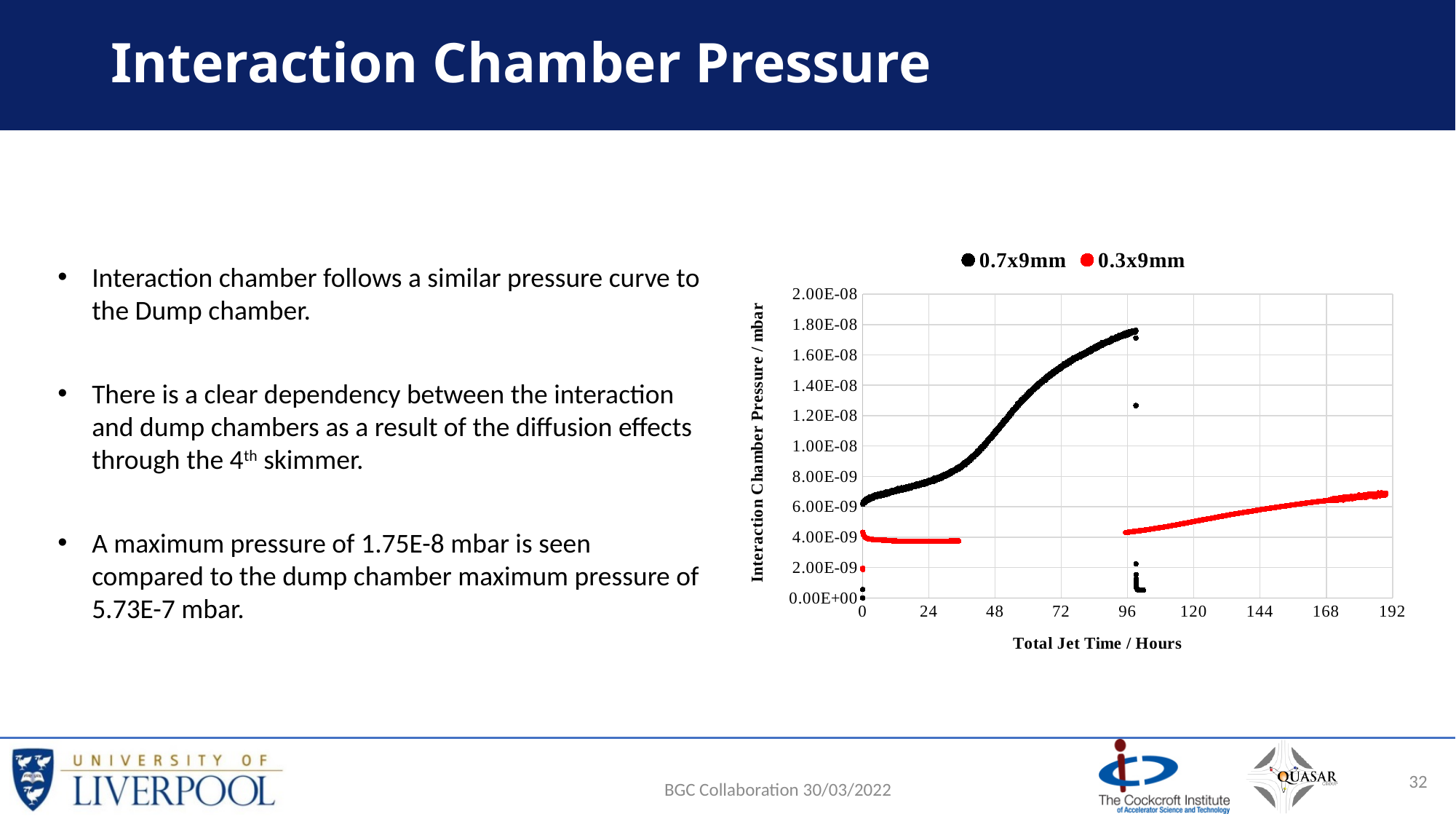
Is the peak value of the 0.7x9mm series greater or less than 1.60E-08? greater At around 96 hours, which series has the higher pressure, 0.7x9mm or 0.3x9mm? 0.7x9mm Does the 0.3x9mm series rise or fall between 96 and 192 hours? rise Is the value of the 0.3x9mm series at 24 hours greater or less than 6.00E-09? less How many series does the chart legend list? 2 What is the title of the chart's x axis? Total Jet Time / Hours What kind of chart is shown on the slide? scatter chart What are the two series named in the chart legend? 0.7x9mm and 0.3x9mm Which series reaches the highest pressure on the chart? 0.7x9mm Does the 0.7x9mm series rise or fall between 0 and 96 hours? rise Is the value of the 0.3x9mm series at 192 hours greater or less than 8.00E-09? less